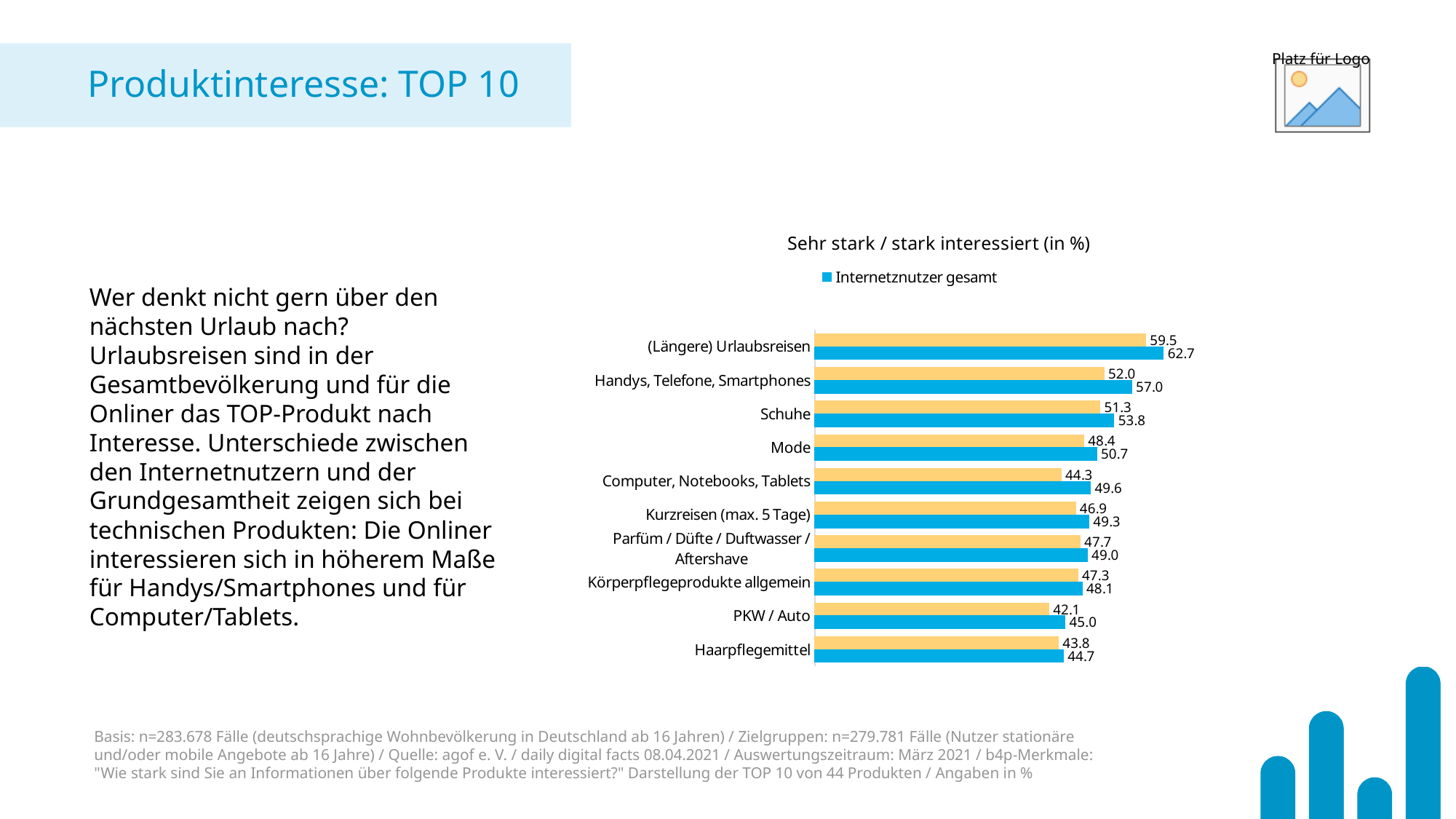
What is the difference between the Internetnutzer gesamt value and the yellow bar value for Computer, Notebooks, Tablets? 5.3 What kind of chart is shown on the slide? Bar chart What is the value for Internetnutzer gesamt for Schuhe? 53.8 How many series does the legend list? 1 What is the difference between the Internetnutzer gesamt values for (Längere) Urlaubsreisen and Handys, Telefone, Smartphones? 5.7 Which category has the highest value for Internetnutzer gesamt? (Längere) Urlaubsreisen What is the value for Internetnutzer gesamt for (Längere) Urlaubsreisen? 62.7 Which category has the lowest value for Internetnutzer gesamt? Haarpflegemittel Which has the larger Internetnutzer gesamt value, Mode or Kurzreisen (max. 5 Tage)? Mode What is the value shown on the yellow bar for Handys, Telefone, Smartphones? 52.0 How many product categories are shown in the chart? 10 What is the value for Internetnutzer gesamt for PKW / Auto? 45.0